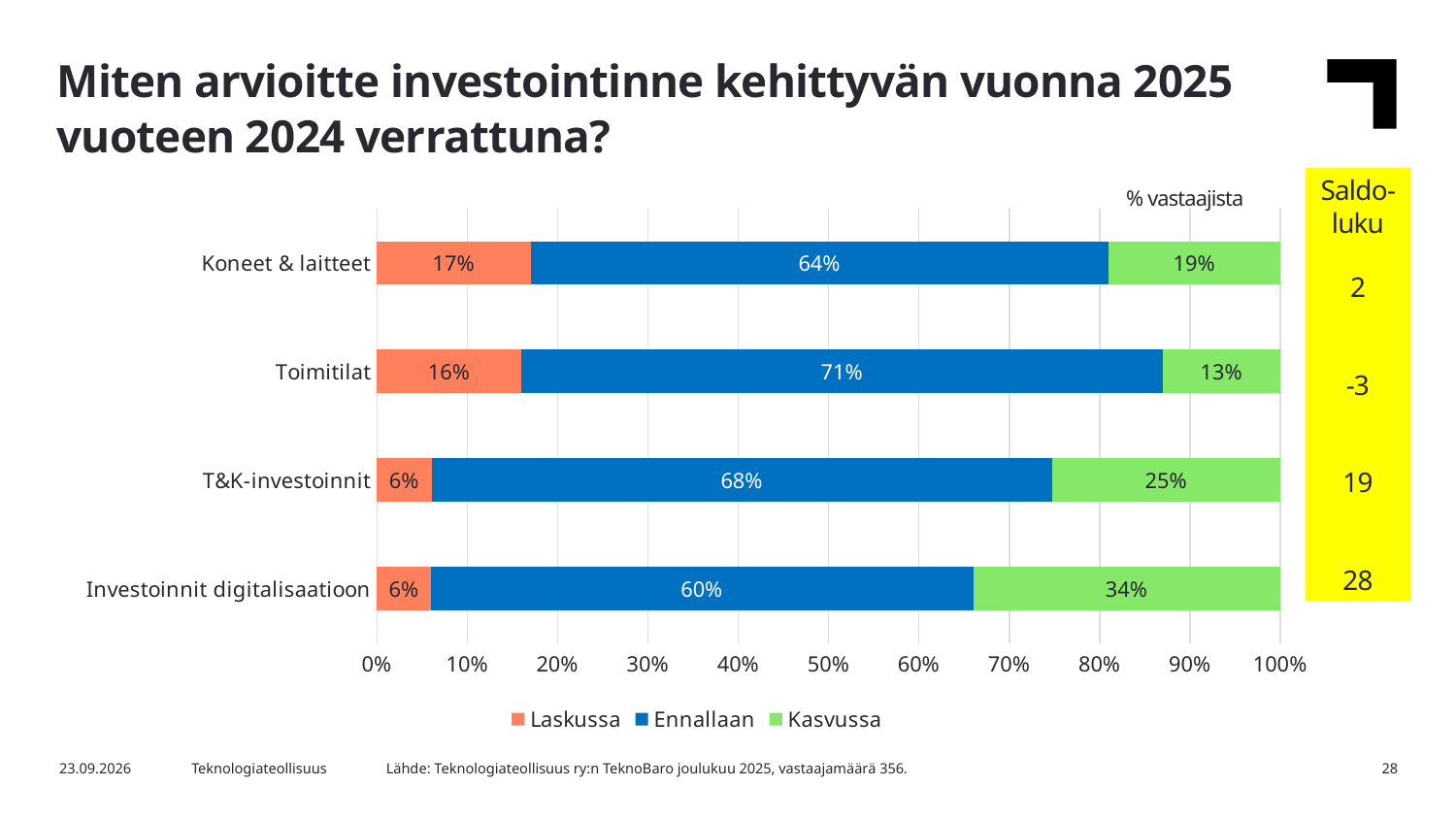
What is the difference between the Kasvussa values for T&K-investoinnit and Koneet & laitteet? 6% What is the total of the stacked bar for Toimitilat? 100% Which category has the highest Kasvussa value? Investoinnit digitalisaatioon What kind of chart is shown on the slide? Stacked bar chart What is the Laskussa value for Koneet & laitteet? 17% What is the Ennallaan value for Toimitilat? 71% Which is larger: the Ennallaan value for Koneet & laitteet or for T&K-investoinnit? T&K-investoinnit Which series is shown in green in the legend? Kasvussa Which category has the lowest Kasvussa value? Toimitilat What is the Kasvussa value for Investoinnit digitalisaatioon? 34% How many series does the legend list? 3 How many categories are shown on the chart? 4